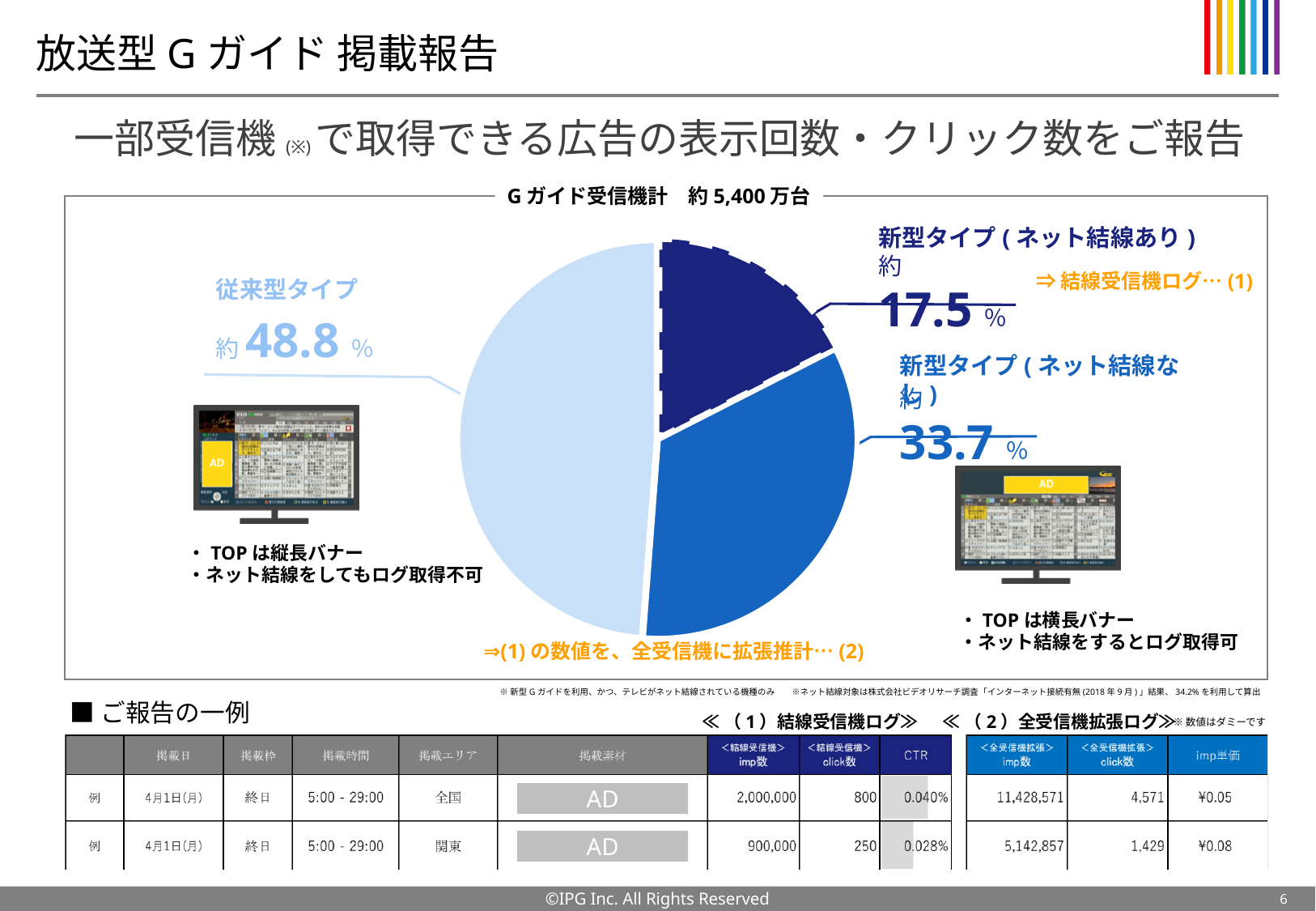
How many slices does the pie chart have? 3 What is the difference in percentage points between 従来型タイプ and 新型タイプ(ネット結線なし)? 15.1 What percentage of the pie is 新型タイプ(ネット結線あり)? 17.5% What is the difference in percentage points between 新型タイプ(ネット結線なし) and 新型タイプ(ネット結線あり)? 16.2 Which is larger: the share for 新型タイプ(ネット結線あり) or the share for 新型タイプ(ネット結線なし)? 新型タイプ(ネット結線なし) Which slice of the pie chart is the smallest? 新型タイプ(ネット結線あり) Which slice of the pie chart is drawn in the lightest blue? 従来型タイプ What percentage of the pie is 新型タイプ(ネット結線なし)? 33.7% What percentage of the pie is 従来型タイプ? 48.8% What type of chart is shown on the slide? pie chart Which slice of the pie chart is the largest? 従来型タイプ What total number of G guide receivers is stated above the pie chart? 約5,400万台